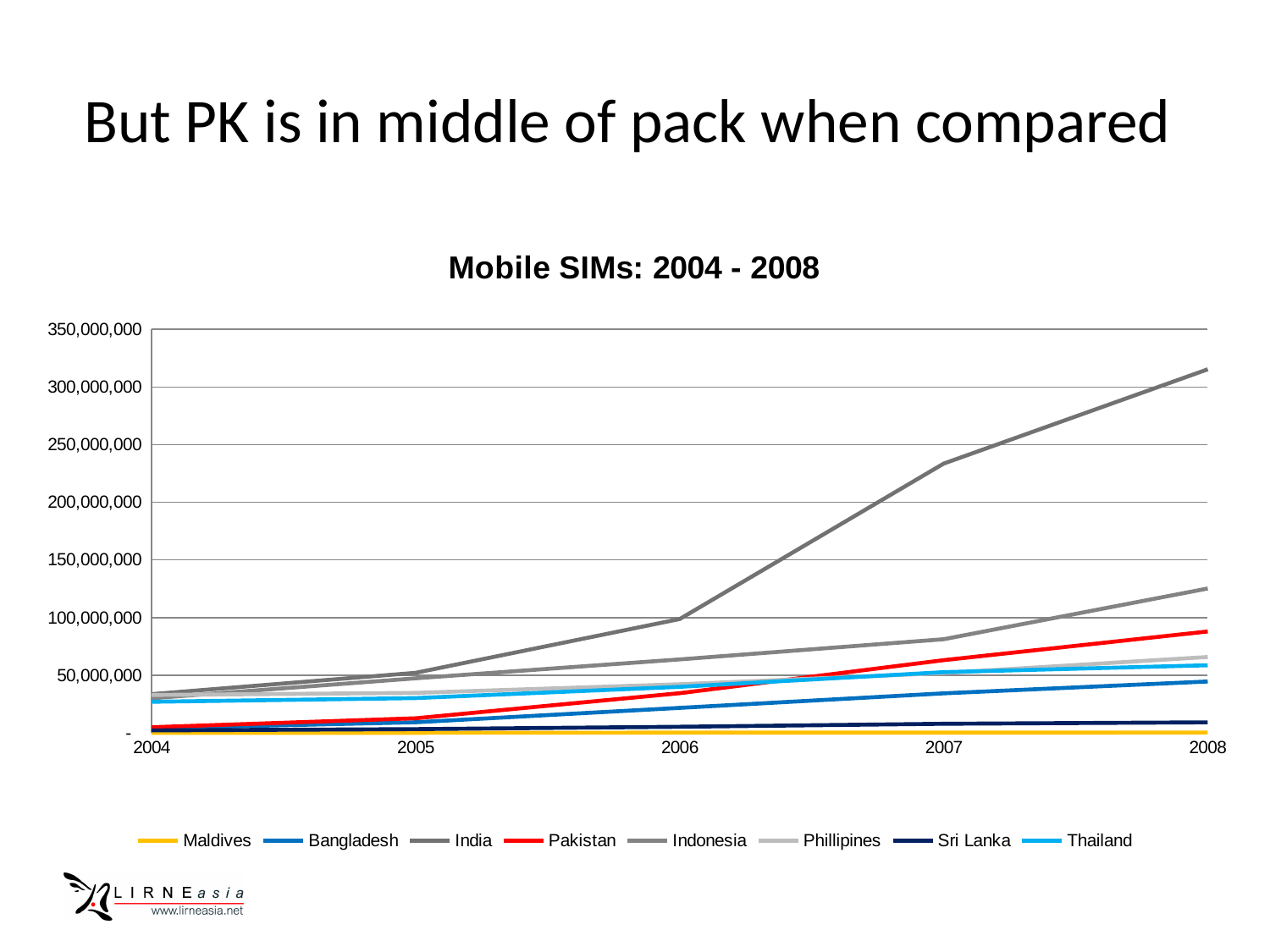
Is the value for India in 2008 greater or less than 300,000,000? greater How many series does the legend list? 8 Is the value for India in 2007 greater or less than 200,000,000? greater Does the number of mobile SIMs for India rise or fall from 2004 to 2008? Rise What kind of chart is shown on the slide? Line chart What is the title of the chart? Mobile SIMs: 2004 - 2008 Which country has the lowest number of mobile SIMs in 2008? Maldives Is the value for Pakistan in 2004 greater or less than 50,000,000? less Which country has the highest number of mobile SIMs in 2008? India How many years are shown along the x axis? 5 In 2008, which has more mobile SIMs, Pakistan or Bangladesh? Pakistan